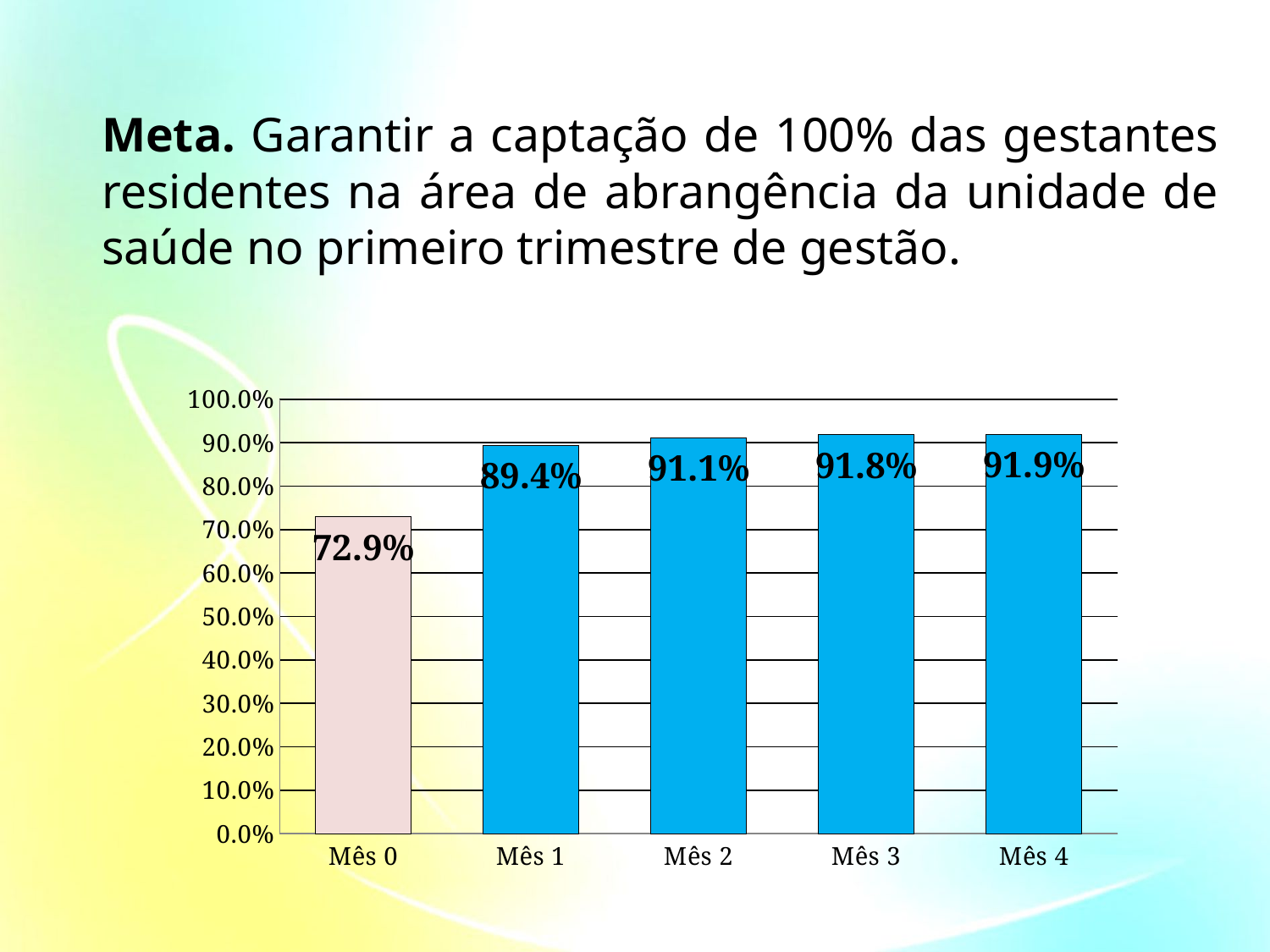
Is the value for Mês 0 greater or less than 80.0%? less What is the value for Mês 0? 72.9% Do the values rise or fall from Mês 0 to Mês 4? rise Which category has the lowest value? Mês 0 What is the value for Mês 2? 91.1% What is the value for Mês 4? 91.9% How many categories are shown on the x axis? 5 What kind of chart is shown on the slide? bar chart What is the value for Mês 1? 89.4% What is the difference between the values for Mês 1 and Mês 0? 16.5% Which is larger, the value for Mês 1 or the value for Mês 2? Mês 2 What is the difference between the values for Mês 4 and Mês 3? 0.1%